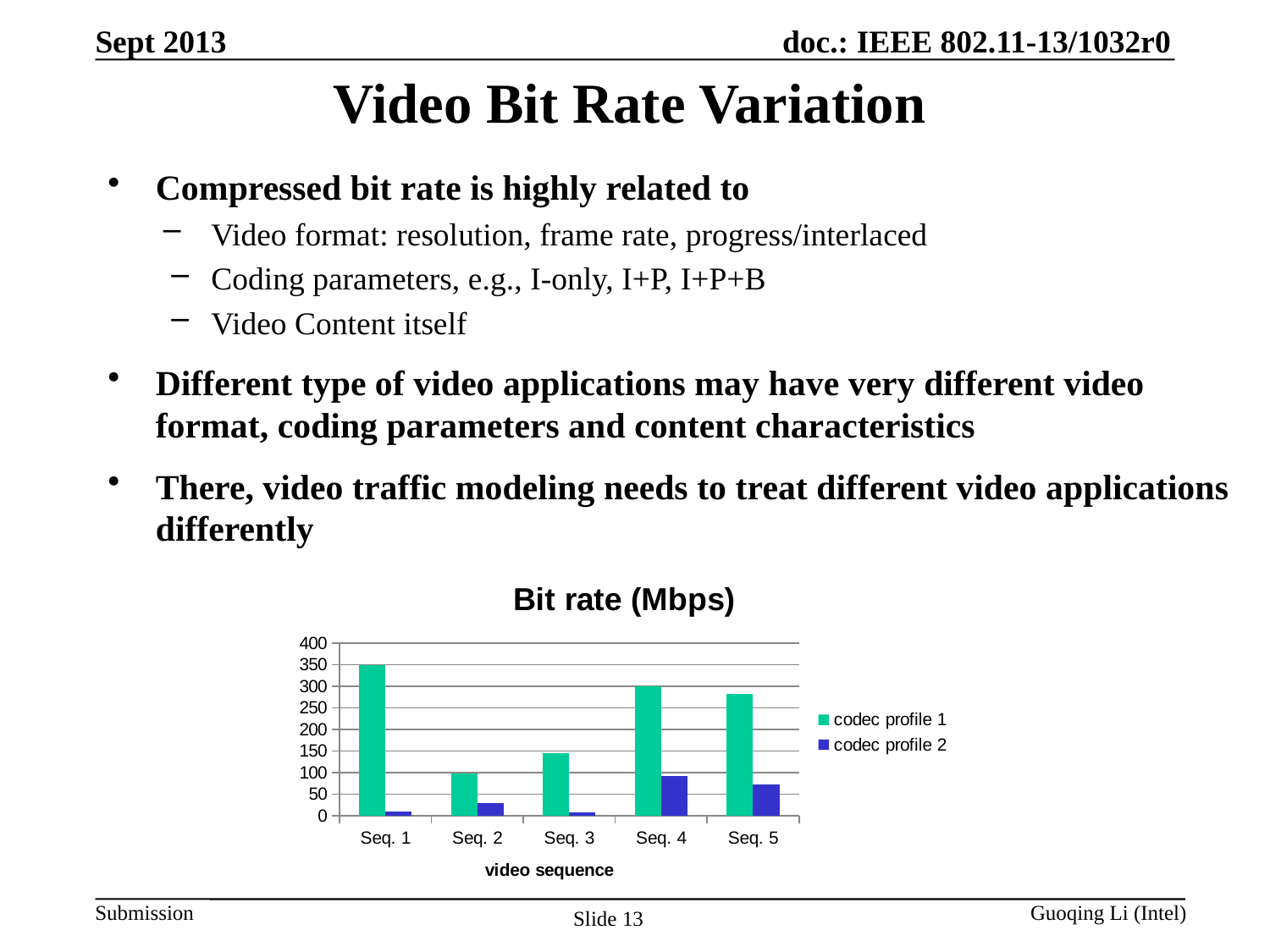
Which video sequence has the highest bit rate for codec profile 1? Seq. 1 Which video sequence has the highest bit rate for codec profile 2? Seq. 4 For codec profile 1, which has the larger bit rate, Seq. 4 or Seq. 5? Seq. 4 What is the title of the chart? Bit rate (Mbps) How many series does the chart's legend list? 2 How many video sequences are shown on the x axis of the chart? 5 For codec profile 2, which has the larger bit rate, Seq. 2 or Seq. 5? Seq. 5 What kind of chart is shown on the slide? bar chart Is the codec profile 1 bit rate for Seq. 3 greater or less than 200? less Is the codec profile 2 bit rate for Seq. 4 greater or less than 50? greater Is the codec profile 1 bit rate for Seq. 1 greater or less than 300? greater Which video sequence has the lowest bit rate for codec profile 1? Seq. 2